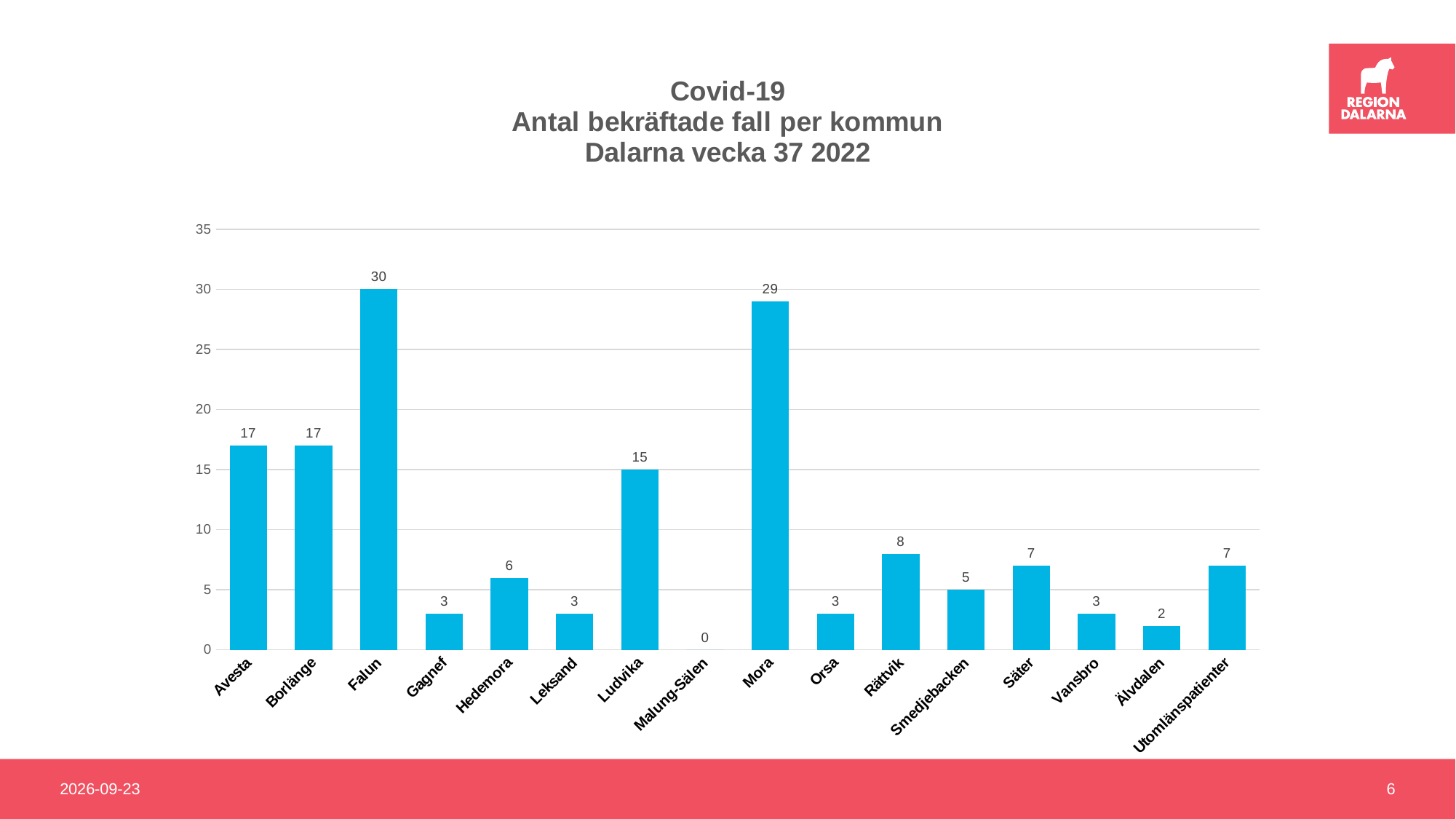
What is the value for Malung-Sälen? 0 What is the difference between the values for Avesta and Rättvik? 9 How many categories are shown on the x axis? 16 Is the value for Mora greater or less than 25? greater What is the value for Ludvika? 15 Which category has the lowest value? Malung-Sälen How many confirmed cases are shown for Falun? 30 What is the title of the chart? Covid-19 Antal bekräftade fall per kommun Dalarna vecka 37 2022 Which municipality has the highest number of confirmed cases? Falun What kind of chart is this? bar chart Which has a larger value, Säter or Smedjebacken? Säter What is the difference between the values for Falun and Mora? 1